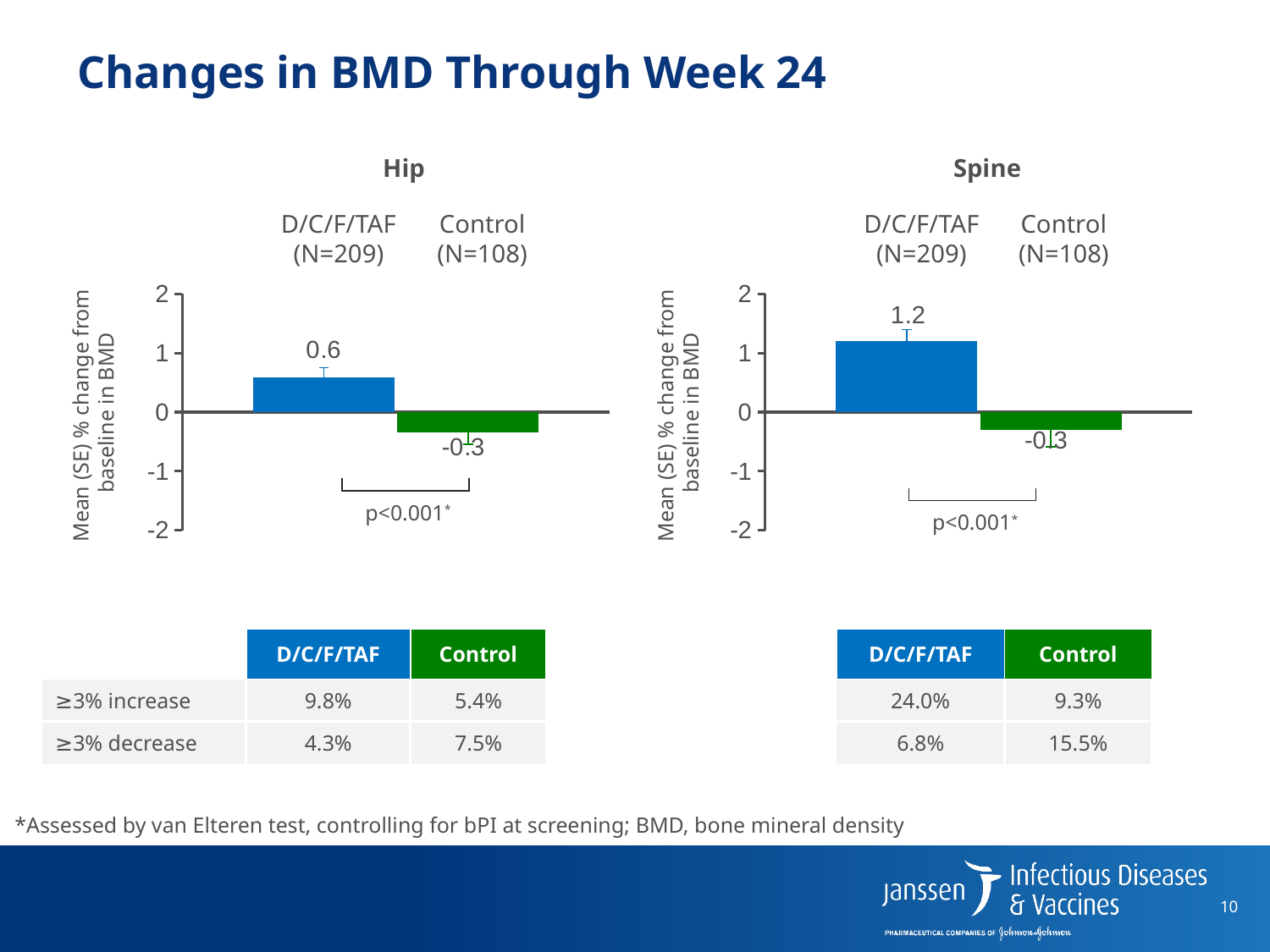
What is the p-value shown in the Hip chart for the comparison between D/C/F/TAF and Control? p<0.001 In the Hip chart, which group has the lower mean % change from baseline in BMD? Control In the Hip chart, what is the difference between the D/C/F/TAF and Control mean % change values? 0.9 In the Spine chart, what is the mean % change from baseline in BMD for D/C/F/TAF? 1.2 Is the D/C/F/TAF value in the Hip chart greater or less than 1? less In the Spine chart, what is the mean % change from baseline in BMD for Control? -0.3 In the Spine chart, what is the difference between the D/C/F/TAF and Control mean % change values? 1.5 What type of chart is used for the Hip and Spine panels? Bar chart In the Hip chart, what is the mean % change from baseline in BMD for Control? -0.3 Is the D/C/F/TAF value in the Spine chart greater or less than 1? greater In the Spine chart, which group has the higher mean % change from baseline in BMD? D/C/F/TAF In the Hip chart, what is the mean % change from baseline in BMD for D/C/F/TAF? 0.6